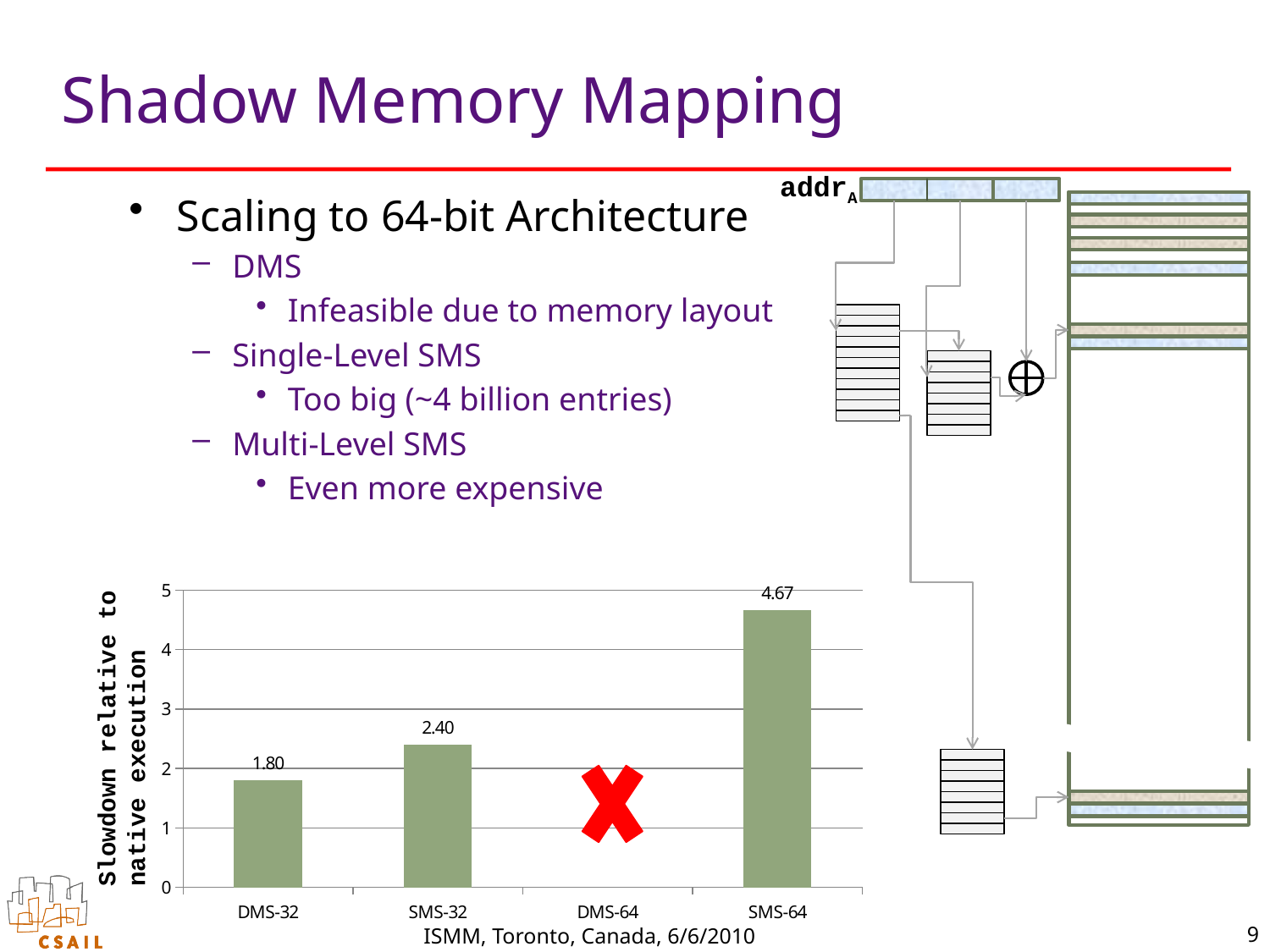
How many categories are labelled on the x axis of the chart? 4 What is the label of the chart's vertical axis? Slowdown relative to native execution What is the slowdown value shown for SMS-64? 4.67 What is the difference between the slowdown values for SMS-32 and DMS-32? 0.60 What is the slowdown value shown for DMS-32? 1.80 Which category has the highest slowdown bar? SMS-64 Is the slowdown value for SMS-64 greater or less than 4? greater What is the difference between the slowdown values for SMS-64 and SMS-32? 2.27 What is the slowdown value shown for SMS-32? 2.40 What kind of chart is shown on the slide? bar chart Which has a larger slowdown, DMS-32 or SMS-32? SMS-32 Which category with a plotted bar has the lowest slowdown? DMS-32